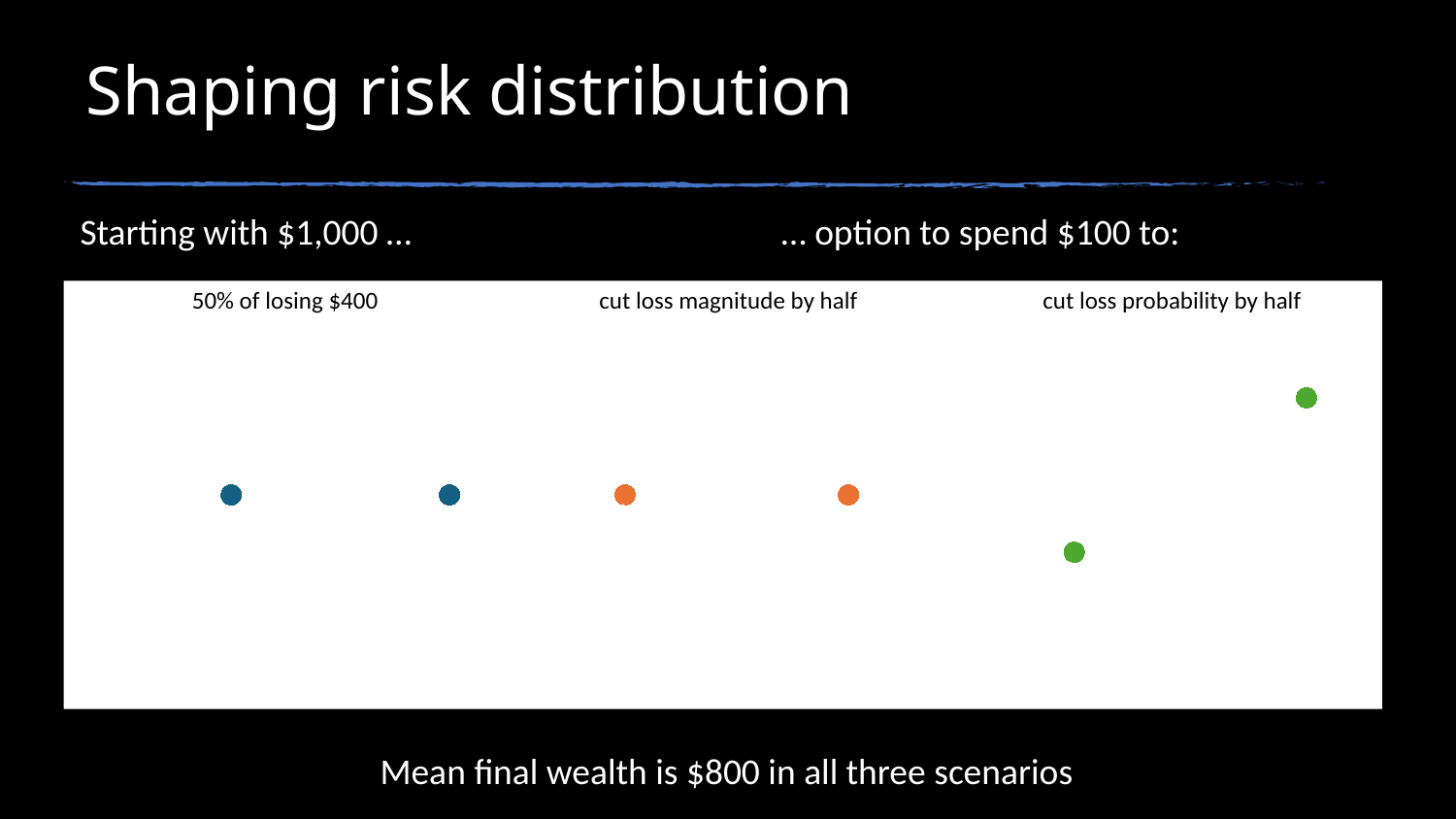
Are the two points for 'cut loss probability by half' at the same height or at different heights? different heights How many points are plotted for the 'cut loss magnitude by half' scenario? 2 How many scenario groups (colours) are plotted in the chart? 3 Which scenario contains the highest plotted point? cut loss probability by half Which scenario's points are plotted in orange? cut loss magnitude by half Which scenario contains the lowest plotted point? cut loss probability by half Are the two points for '50% of losing $400' at the same height or at different heights? same height Is the upper green point for 'cut loss probability by half' higher or lower than the orange points for 'cut loss magnitude by half'? higher What kind of chart is shown on the slide? scatter chart How many data points are plotted in the chart? 6 Which scenario's points are plotted in blue? 50% of losing $400